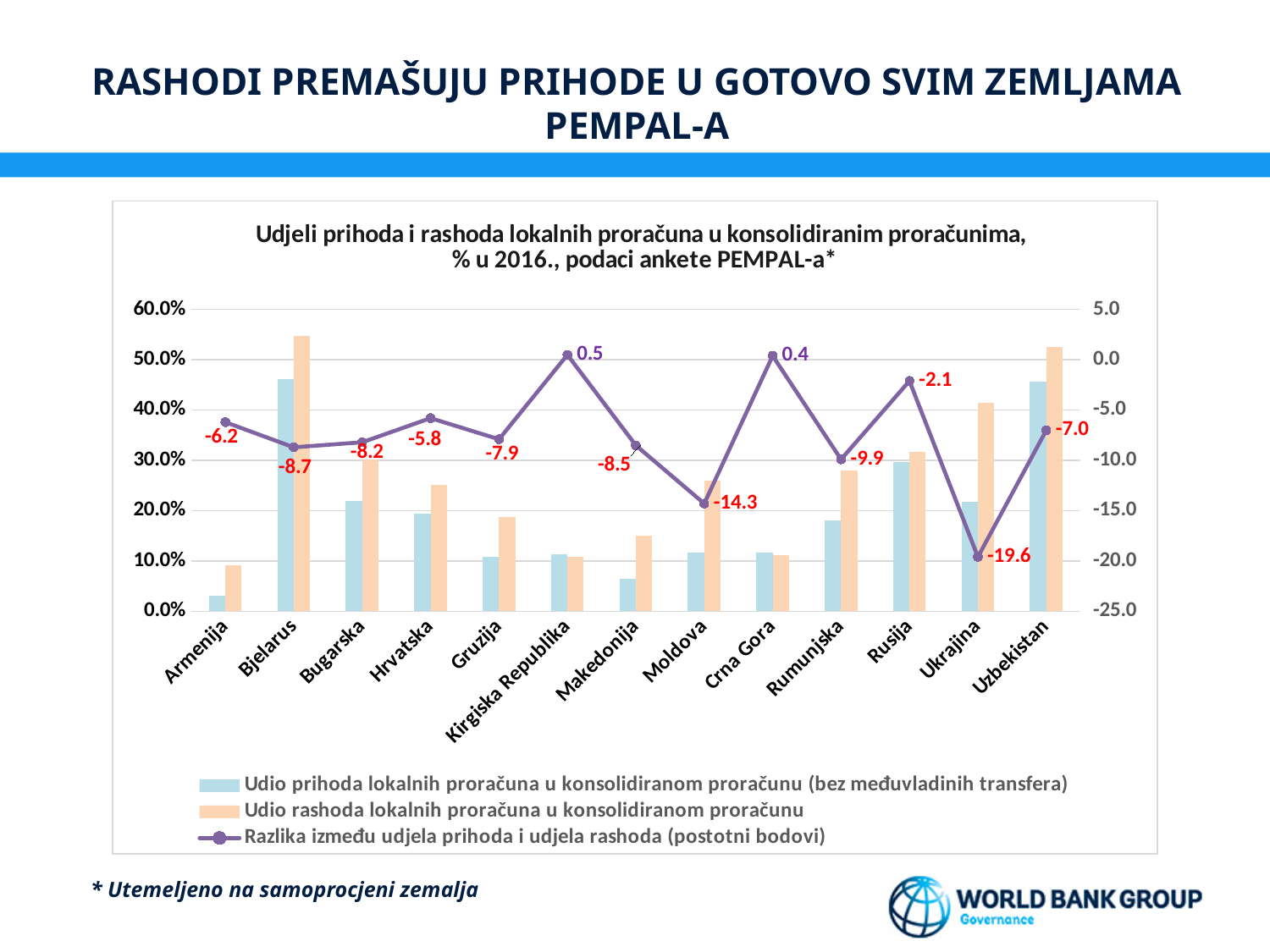
Which country has the lowest value on the difference line (Razlika između udjela prihoda i udjela rashoda)? Ukrajina How many countries are shown on the x axis? 13 Which country has the highest value on the difference line? Kirgiska Republika Is the expenditure share bar (Udio rashoda) for Bjelarus greater or less than 50.0%? greater By how many percentage points does the difference value for Ukrajina differ from that for Moldova? 5.3 What is the value of the difference line for Moldova? -14.3 What is the value of the difference line (Razlika između udjela prihoda i udjela rashoda) for Ukrajina? -19.6 What kind of chart is this? Combined bar and line chart Which has the larger difference-line value, Rusija or Hrvatska? Rusija Is the revenue share bar (Udio prihoda) for Armenija greater or less than 10.0%? less How many series does the legend list? 3 What is the value of the difference line for Kirgiska Republika? 0.5